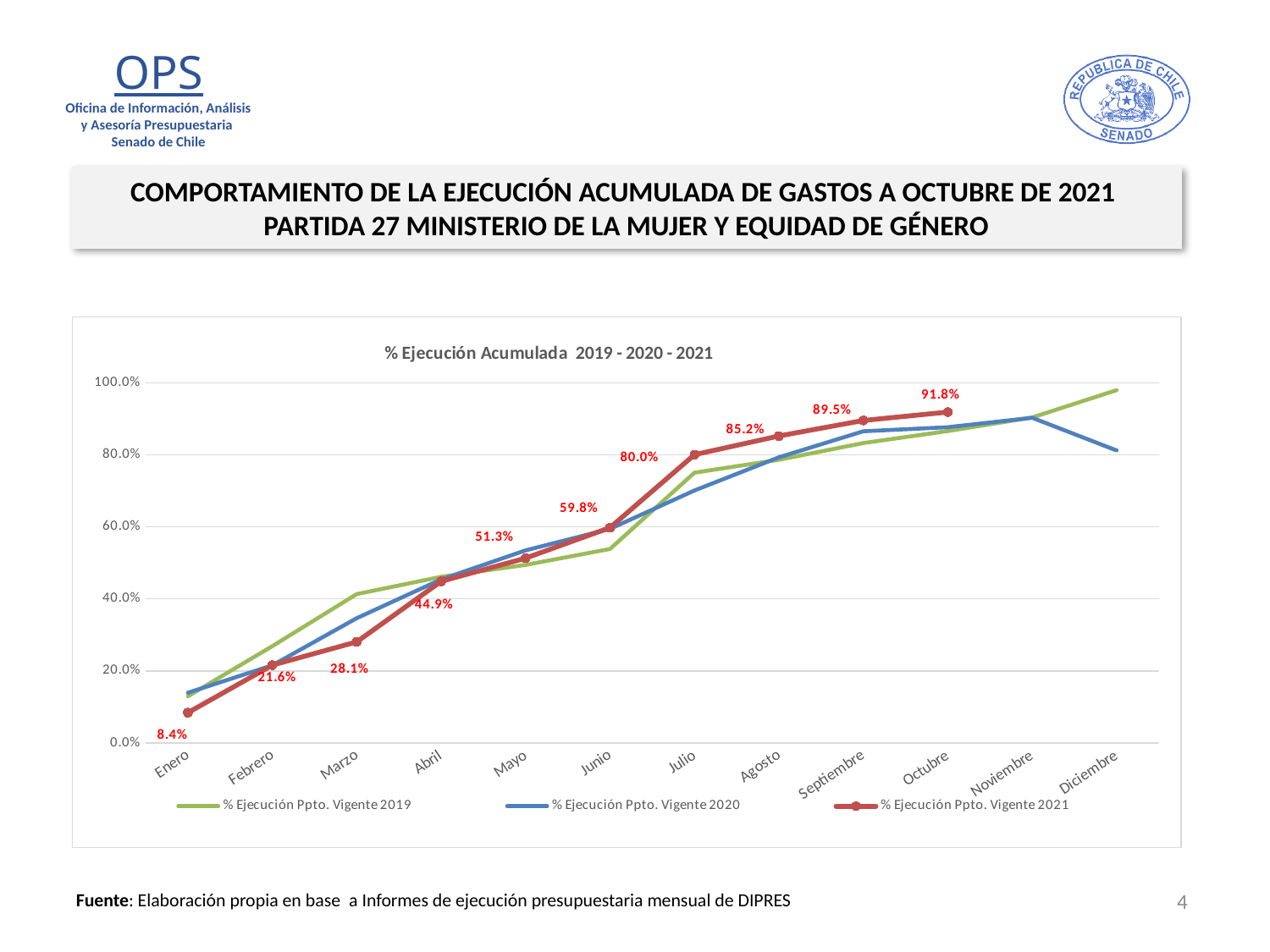
How many series does the legend list? 3 What is the difference between the 2021 values for Julio and Junio? 20.2% In which month does the % Ejecución Ppto. Vigente 2021 series reach its highest labelled value? Octubre By how much did % Ejecución Ppto. Vigente 2021 increase from Septiembre to Octubre? 2.3% What kind of chart is shown on the slide? Line chart What is the value of % Ejecución Ppto. Vigente 2021 for Abril? 44.9% Does the % Ejecución Ppto. Vigente 2021 series rise or fall from Enero to Octubre? Rises What is the value of % Ejecución Ppto. Vigente 2021 for Octubre? 91.8% Which series has the larger value in Diciembre, % Ejecución Ppto. Vigente 2019 or % Ejecución Ppto. Vigente 2020? % Ejecución Ppto. Vigente 2019 How many months are shown on the x axis? 12 What is the value of % Ejecución Ppto. Vigente 2021 for Enero? 8.4% Is the value for % Ejecución Ppto. Vigente 2019 in Diciembre greater or less than 80.0%? greater